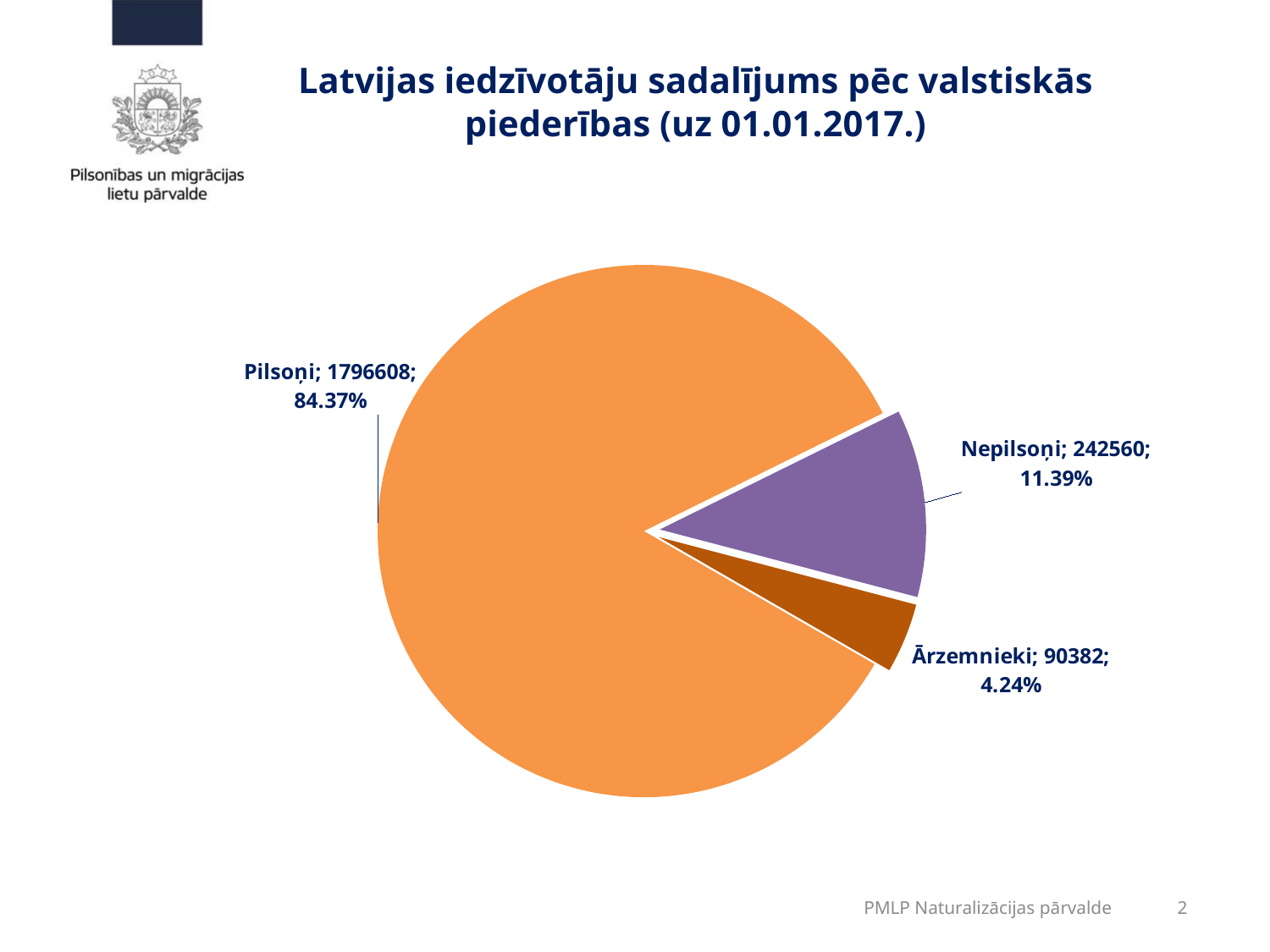
What kind of chart is shown on the slide? pie chart What is the value for Nepilsoņi? 242560 Which category has the smallest slice? Ārzemnieki What is the value for Ārzemnieki? 90382 What share of the pie does Nepilsoņi represent? 11.39% Which category has the largest slice? Pilsoņi What share of the pie does Ārzemnieki represent? 4.24% How many slices does the pie chart have? 3 What colour is the Pilsoņi slice? orange What is the difference between the values for Nepilsoņi and Ārzemnieki? 152178 Which is larger, the value for Nepilsoņi or the value for Ārzemnieki? Nepilsoņi What is the value for Pilsoņi? 1796608